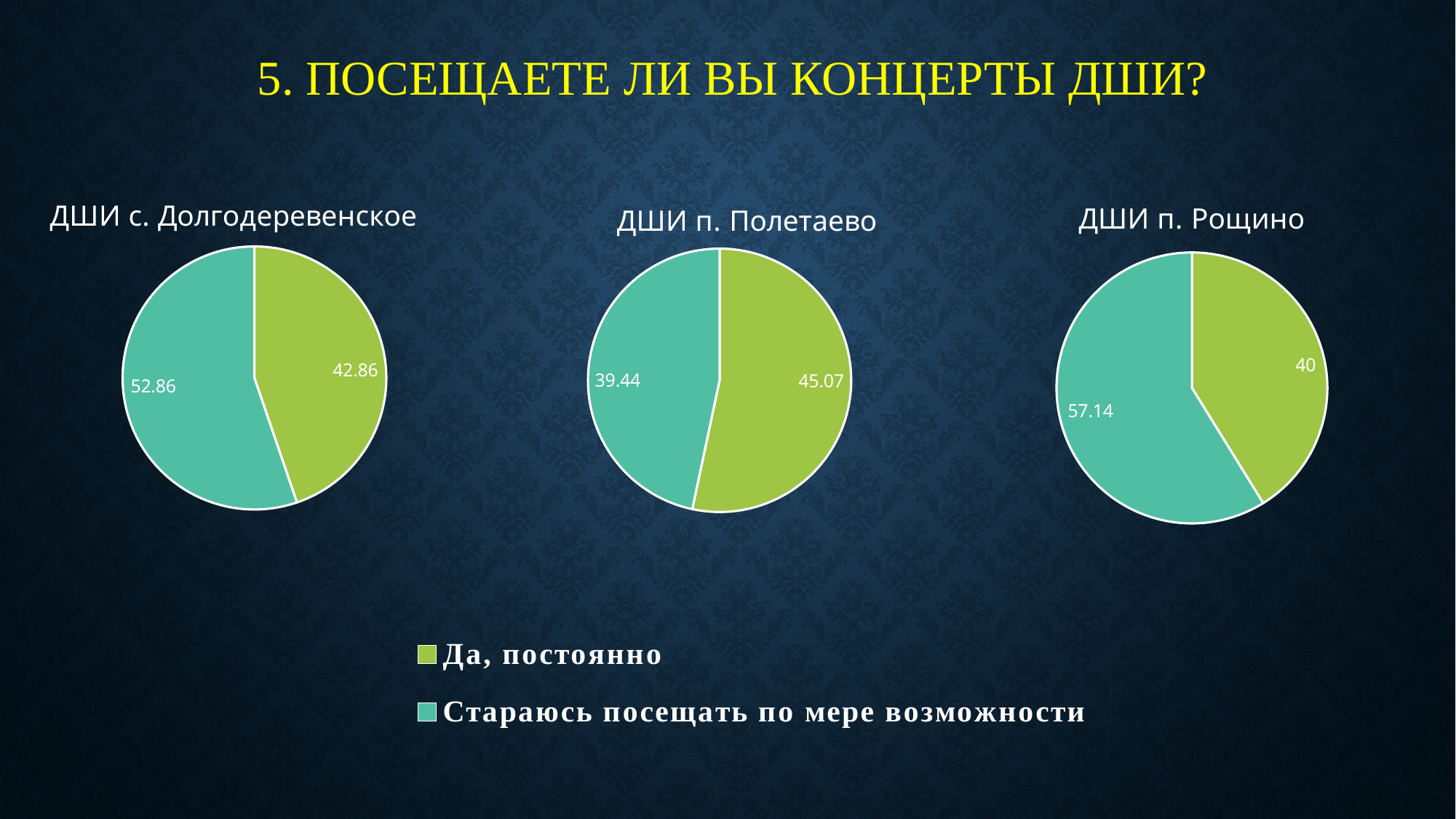
In the chart titled "ДШИ п. Полетаево", what is the value for "Да, постоянно"? 45.07 How many entries does the shared legend list? 2 What type of chart is used for "ДШИ п. Полетаево"? Pie chart In the chart titled "ДШИ п. Рощино", which slice is the largest? Стараюсь посещать по мере возможности In the chart titled "ДШИ п. Рощино", what is the difference between the "Стараюсь посещать по мере возможности" value and the "Да, постоянно" value? 17.14 In the chart titled "ДШИ с. Долгодеревенское", what is the value for "Да, постоянно"? 42.86 In the chart titled "ДШИ п. Рощино", what is the value for "Да, постоянно"? 40 In the chart titled "ДШИ п. Полетаево", what is the value for "Стараюсь посещать по мере возможности"? 39.44 In the chart titled "ДШИ с. Долгодеревенское", what is the value for "Стараюсь посещать по мере возможности"? 52.86 In the chart titled "ДШИ п. Полетаево", which slice is larger: "Да, постоянно" or "Стараюсь посещать по мере возможности"? Да, постоянно In the chart titled "ДШИ п. Рощино", what is the value for "Стараюсь посещать по мере возможности"? 57.14 In the chart titled "ДШИ с. Долгодеревенское", what is the difference between the "Стараюсь посещать по мере возможности" value and the "Да, постоянно" value? 10